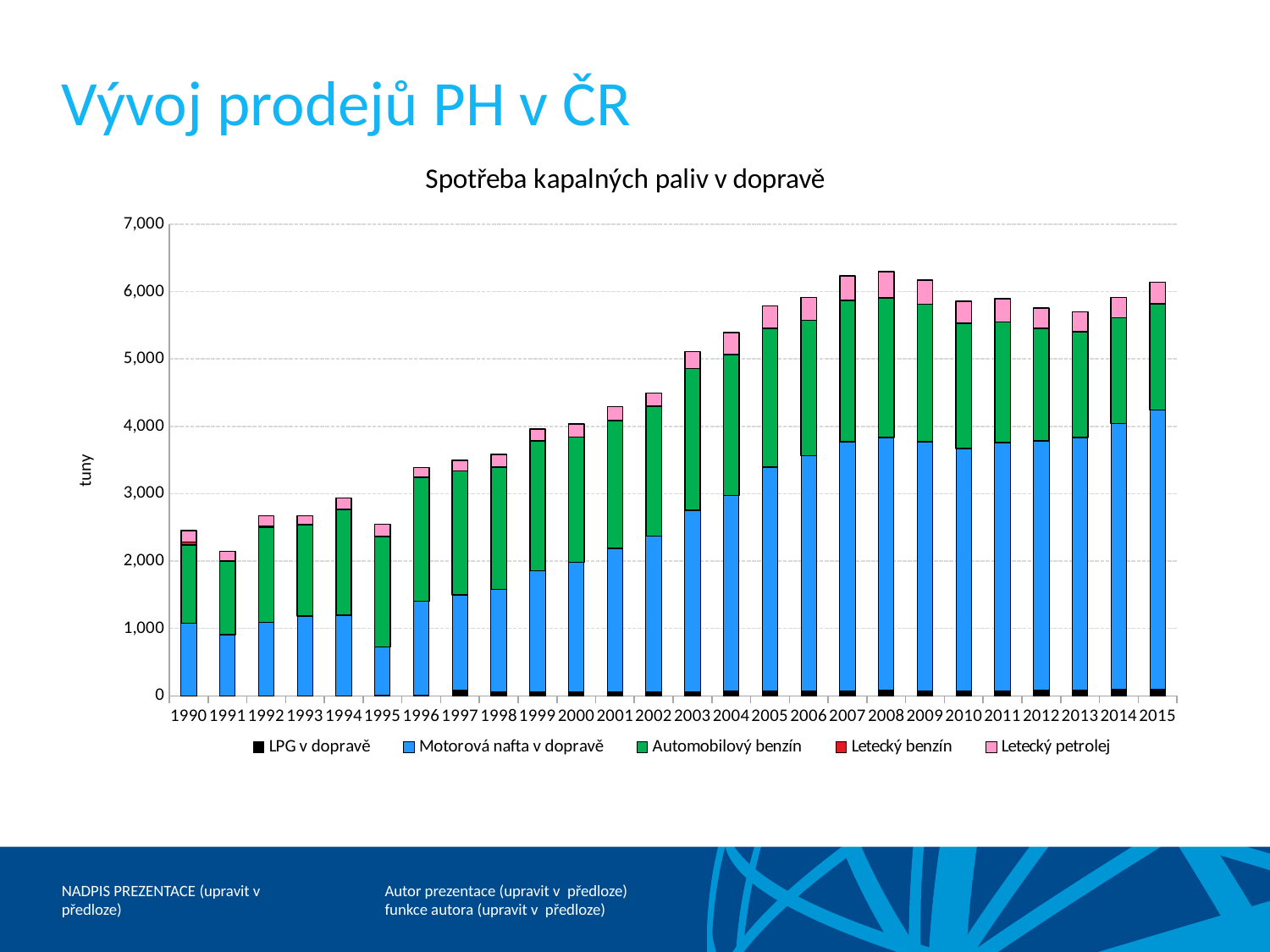
How many years are shown along the x axis? 26 Is the total bar for 2005 greater or less than 5,000? greater Is the total bar for 1990 greater or less than 3,000? less What kind of chart is shown on the slide? stacked bar chart Is the total bar for 2015 greater or less than 6,000? greater How many series does the legend list? 5 Do the total bars generally rise or fall from 1990 to 2008? rise Which year has the larger total bar, 2000 or 2010? 2010 What is the label of the vertical axis? tuny Which year has the lowest total bar? 1991 What is the title of the chart? Spotřeba kapalných paliv v dopravě